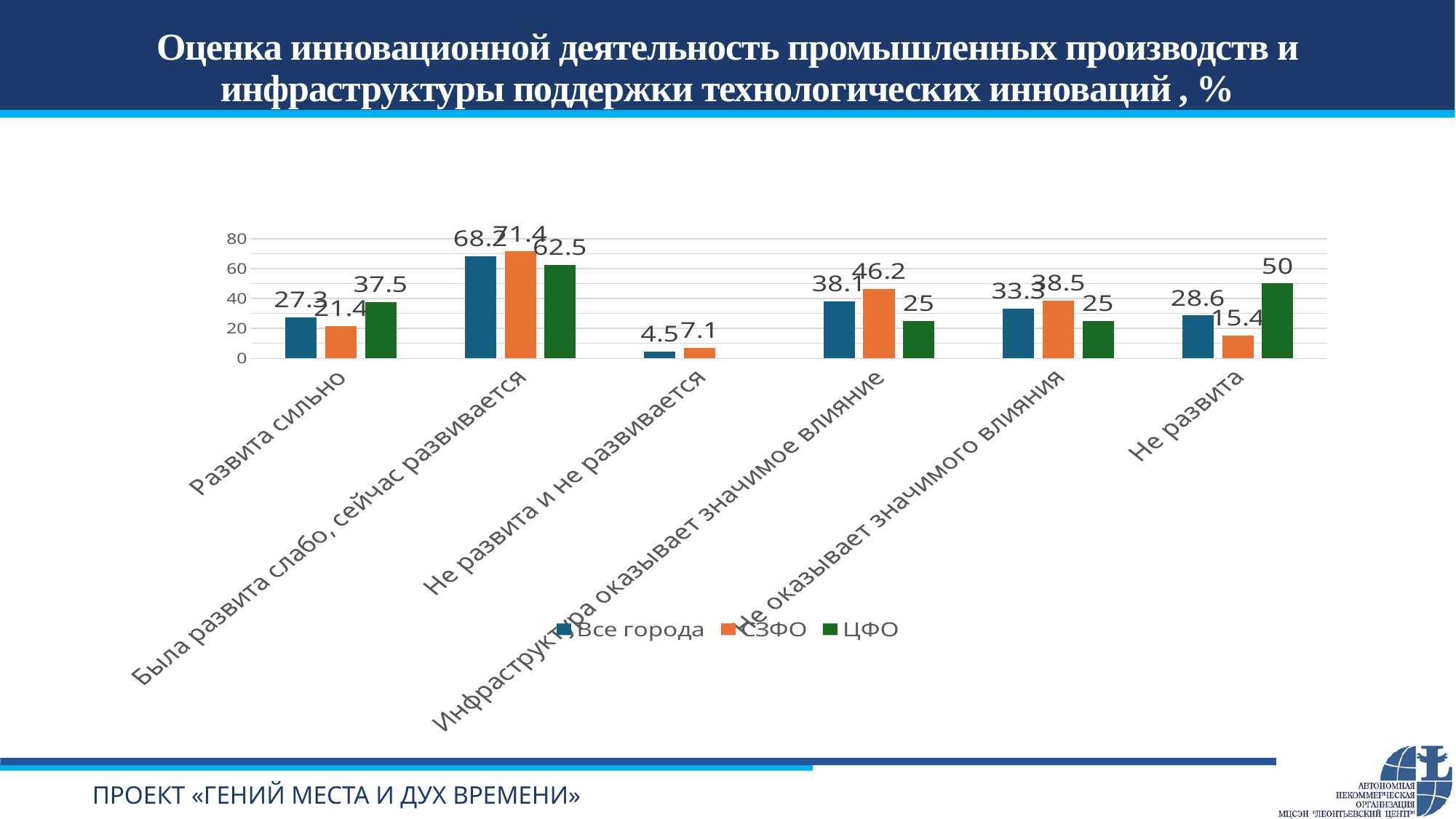
In the category «Инфраструктура оказывает значимое влияние», what is the difference between the СЗФО value and the «Все города» value? 8.1 How many categories are shown on the x axis? 6 What kind of chart is shown on the slide? bar chart In which category does the «Все города» series have its lowest value? Не развита и не развивается Which colour represents the СЗФО series in the legend? orange How many series does the legend list? 3 In which category does the СЗФО series reach its highest value? Была развита слабо, сейчас развивается What is the value for СЗФО in the category «Инфраструктура оказывает значимое влияние»? 46.2 In the category «Развита сильно», which series has the larger value: «Все города» or ЦФО? ЦФО What is the value for ЦФО in the category «Не развита»? 50 What is the value for «Все города» in the category «Развита сильно»? 27.3 In the category «Не развита», what is the difference between the ЦФО value and the СЗФО value? 34.6